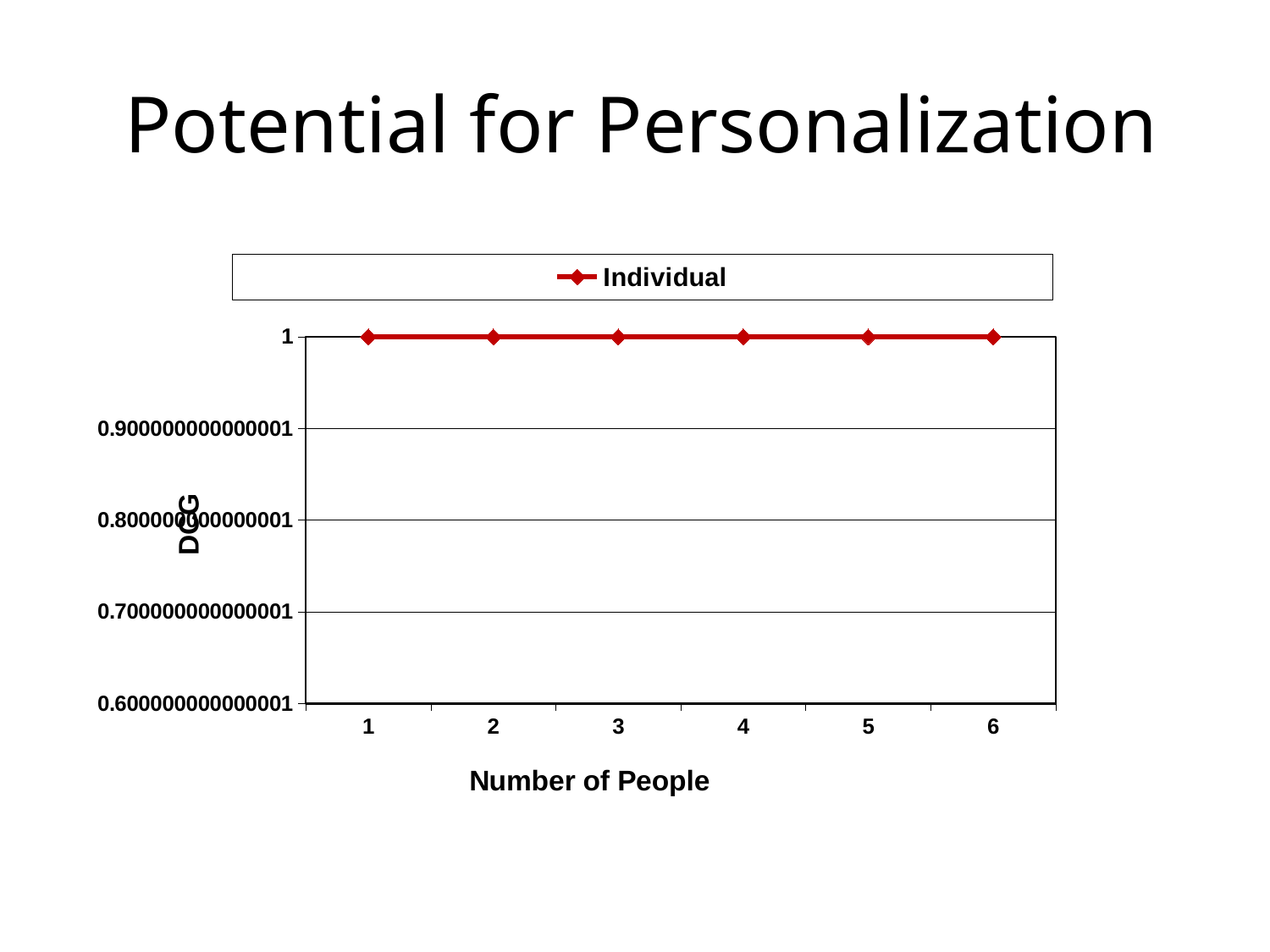
Do the DCG values for the Individual series rise, fall, or stay flat as the number of people increases from 1 to 6? stay flat What is the DCG value for the Individual series when the number of people is 6? 1 What is the name of the series shown in the legend? Individual What is the DCG value for the Individual series when the number of people is 1? 1 What is the lowest value shown on the y axis? 0.600000000000001 How many data points are plotted for the Individual series? 6 How many series does the legend list? 1 Is the DCG value for the Individual series at 3 people greater or less than 0.900000000000001? greater What kind of chart is shown on the slide? line chart What is the label of the x axis? Number of People What is the difference between the DCG value at 1 person and the DCG value at 6 people for the Individual series? 0